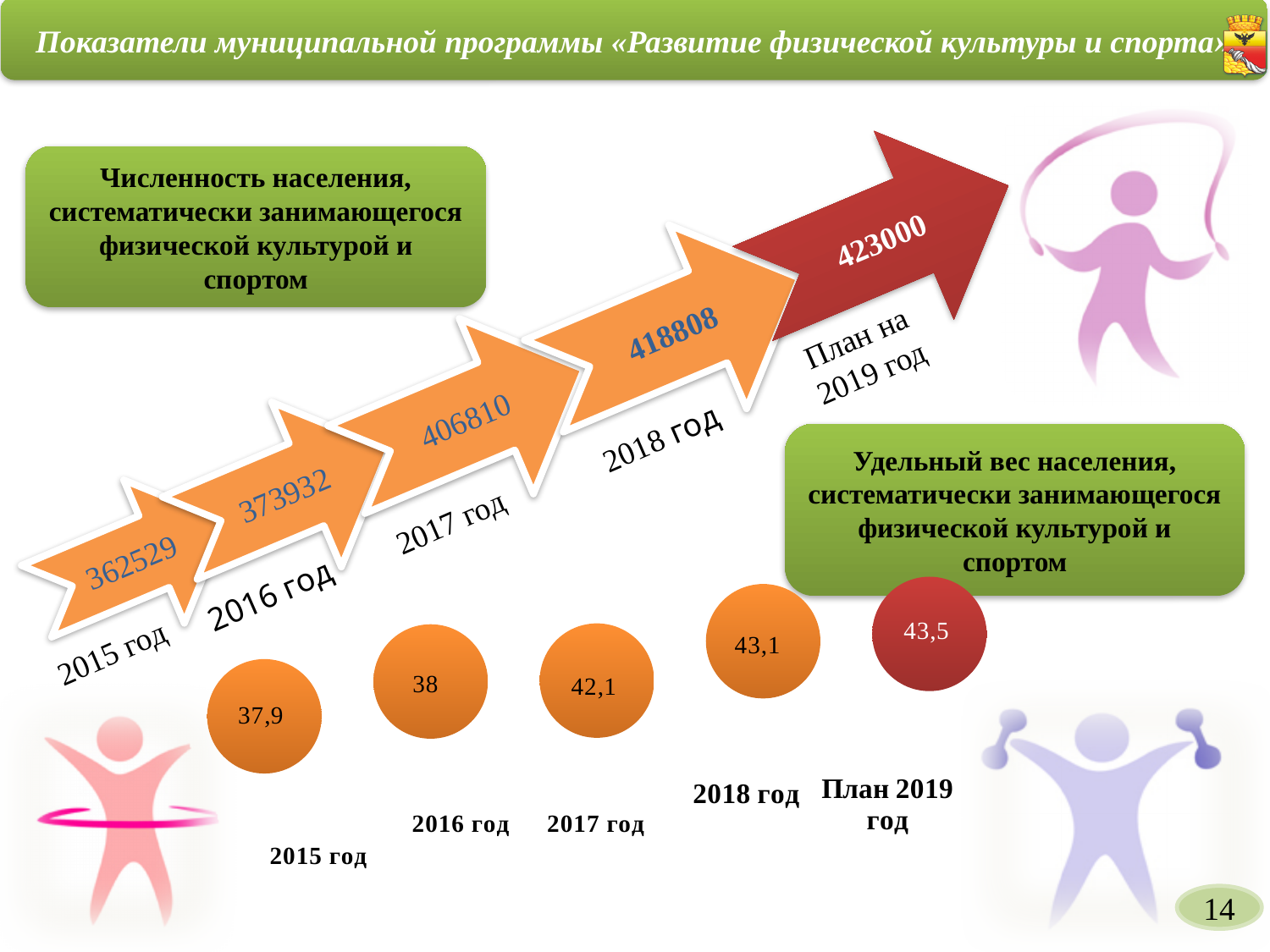
In the upper chart (Численность населения), which year has the lowest value? 2015 год In the upper chart (Численность населения), what is the value for 2017 год? 406810 In the lower chart (Удельный вес населения), what is the difference between the 2017 год value and the 2016 год value? 4,1 In the lower chart (Удельный вес населения), what is the value for 2018 год? 43,1 In the upper chart (Численность населения), do the values rise or fall from 2015 to the 2019 plan? rise In the lower chart (Удельный вес населения), which year has the highest value? План 2019 год In the lower chart (Удельный вес населения, систематически занимающегося физической культурой и спортом), what is the value for 2016 год? 38 In the upper chart (Численность населения, систематически занимающегося физической культурой и спортом), what is the value for 2015 год? 362529 In the upper chart (Численность населения), what is the difference between the 2018 год value and the 2017 год value? 11998 In the upper chart (Численность населения), how many years (including the 2019 plan) are shown? 5 In the lower chart (Удельный вес населения), which is larger: the value for 2015 год or the value for 2017 год? 2017 год In the upper chart (Численность населения), what is the planned value for 2019 год? 423000